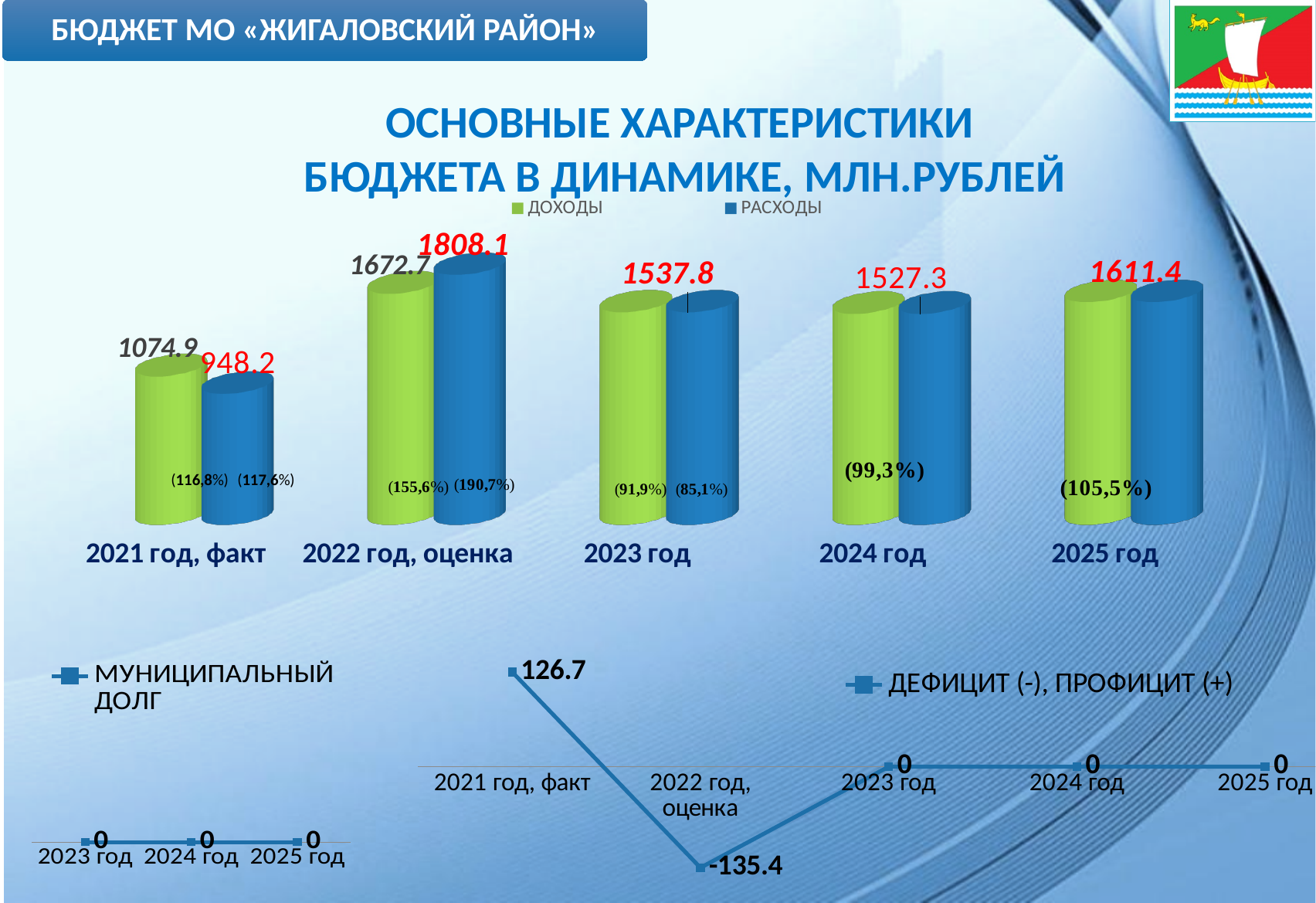
In the top bar chart, which is larger for 2022 год, оценка: ДОХОДЫ or РАСХОДЫ? РАСХОДЫ In the ДЕФИЦИТ (-), ПРОФИЦИТ (+) chart, which year has the lowest value? 2022 год, оценка In the top bar chart, what is the value of ДОХОДЫ for 2021 год, факт? 1074.9 In the top bar chart, by how much do ДОХОДЫ exceed РАСХОДЫ in 2021 год, факт? 126.7 How many year categories are shown on the x axis of the top bar chart? 5 What kind of chart is the top chart showing ДОХОДЫ and РАСХОДЫ? bar chart In the top bar chart, what is the value of РАСХОДЫ for 2022 год, оценка? 1808.1 In the top bar chart, what is the value of РАСХОДЫ for 2021 год, факт? 948.2 In the ДЕФИЦИТ (-), ПРОФИЦИТ (+) chart, what is the value for 2022 год, оценка? -135.4 How many series does the legend of the top bar chart list? 2 In the top bar chart, by how much do РАСХОДЫ exceed ДОХОДЫ in 2022 год, оценка? 135.4 In the МУНИЦИПАЛЬНЫЙ ДОЛГ chart, what is the value for 2024 год? 0